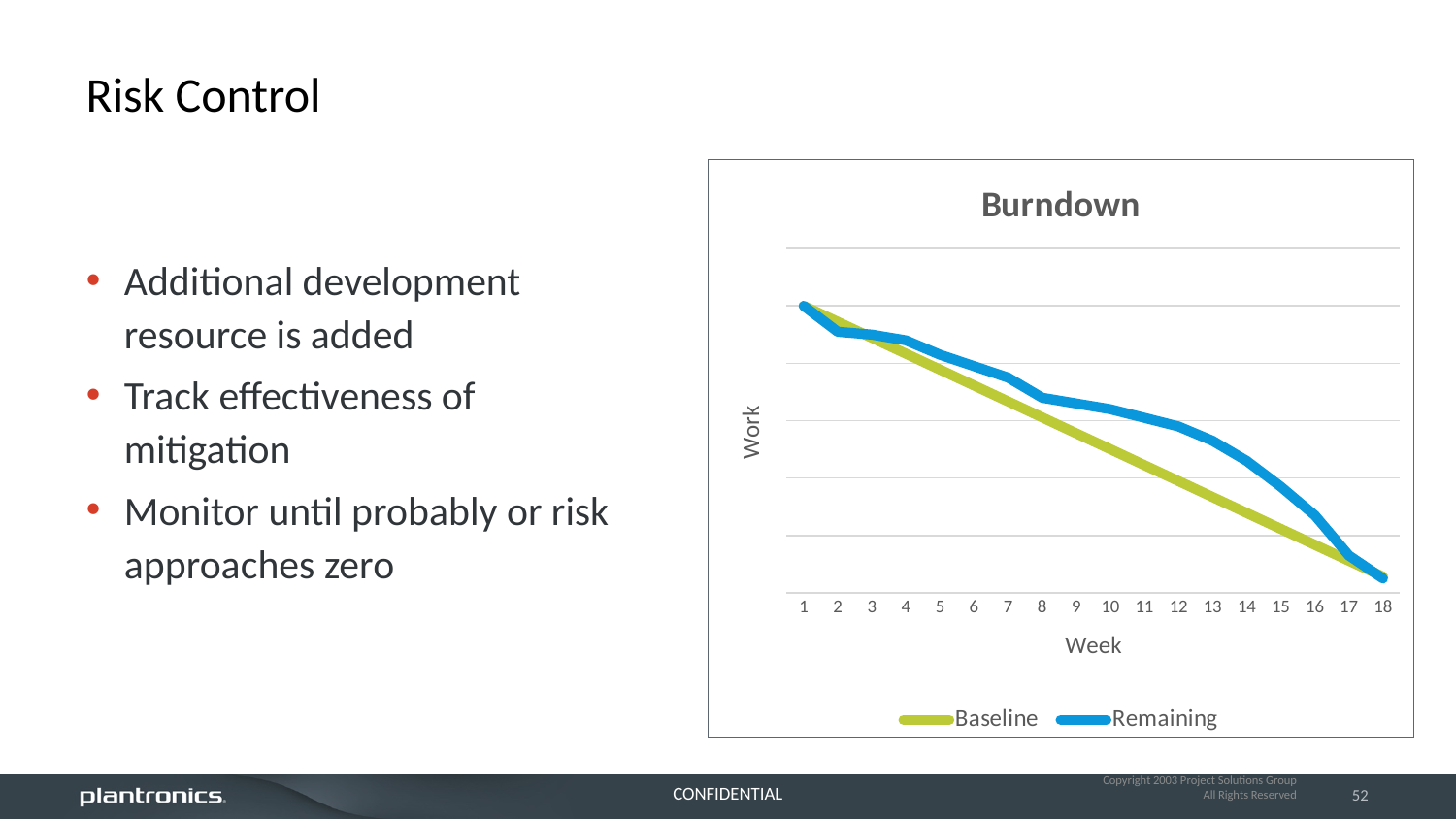
How many weeks are shown along the x axis of the Burndown chart? 18 At which week does the Baseline series have its highest value? 1 What is the title of the chart? Burndown Does the Remaining series trend upward or downward from week 1 to week 18? downward How many series does the legend list? 2 Do the values in the Burndown chart rise or fall as the week number increases? fall Which series is drawn in blue in the Burndown chart? Remaining What is the label of the x axis of the Burndown chart? Week At week 13, is the Remaining line above or below the Baseline line? above At which week does the Remaining series reach its lowest value? 18 At week 10, which series has the higher value, Baseline or Remaining? Remaining What kind of chart is shown on the slide? line chart